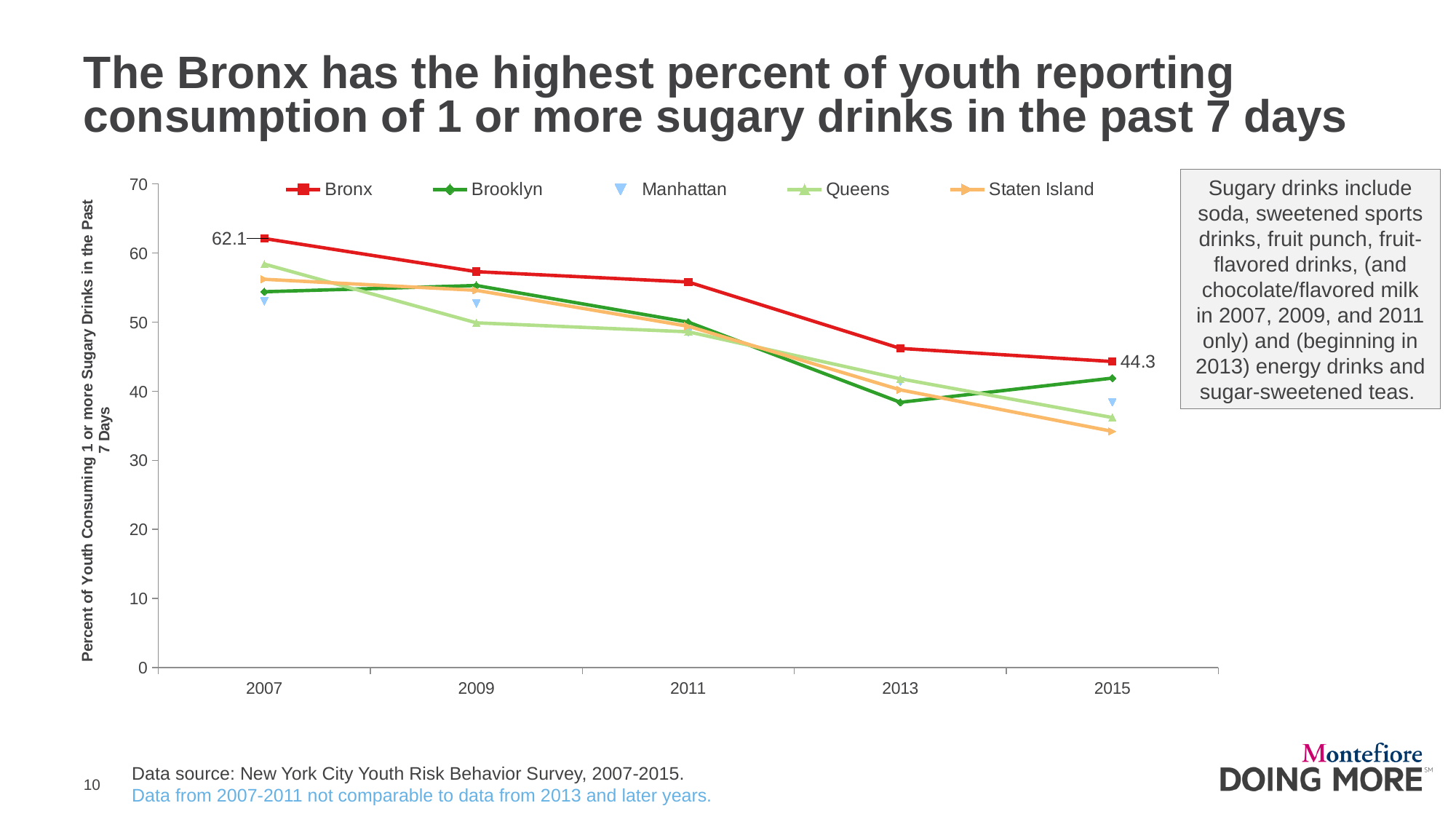
How many series does the legend list? 5 Which borough has the highest value in 2015? Bronx Is the value for Staten Island in 2015 greater or less than 40? less What kind of chart is shown on the slide? Line chart What colour is the Bronx line in the chart? Red Does the Bronx line rise or fall from 2007 to 2015? Fall What is the value for the Bronx in 2007? 62.1 Which is larger in 2011, the value for the Bronx or the value for Brooklyn? Bronx By how much did the Bronx value fall from 2007 to 2015? 17.8 What is the value for the Bronx in 2015? 44.3 How many years are shown on the x axis? 5 Which borough has the lowest value in 2009? Queens